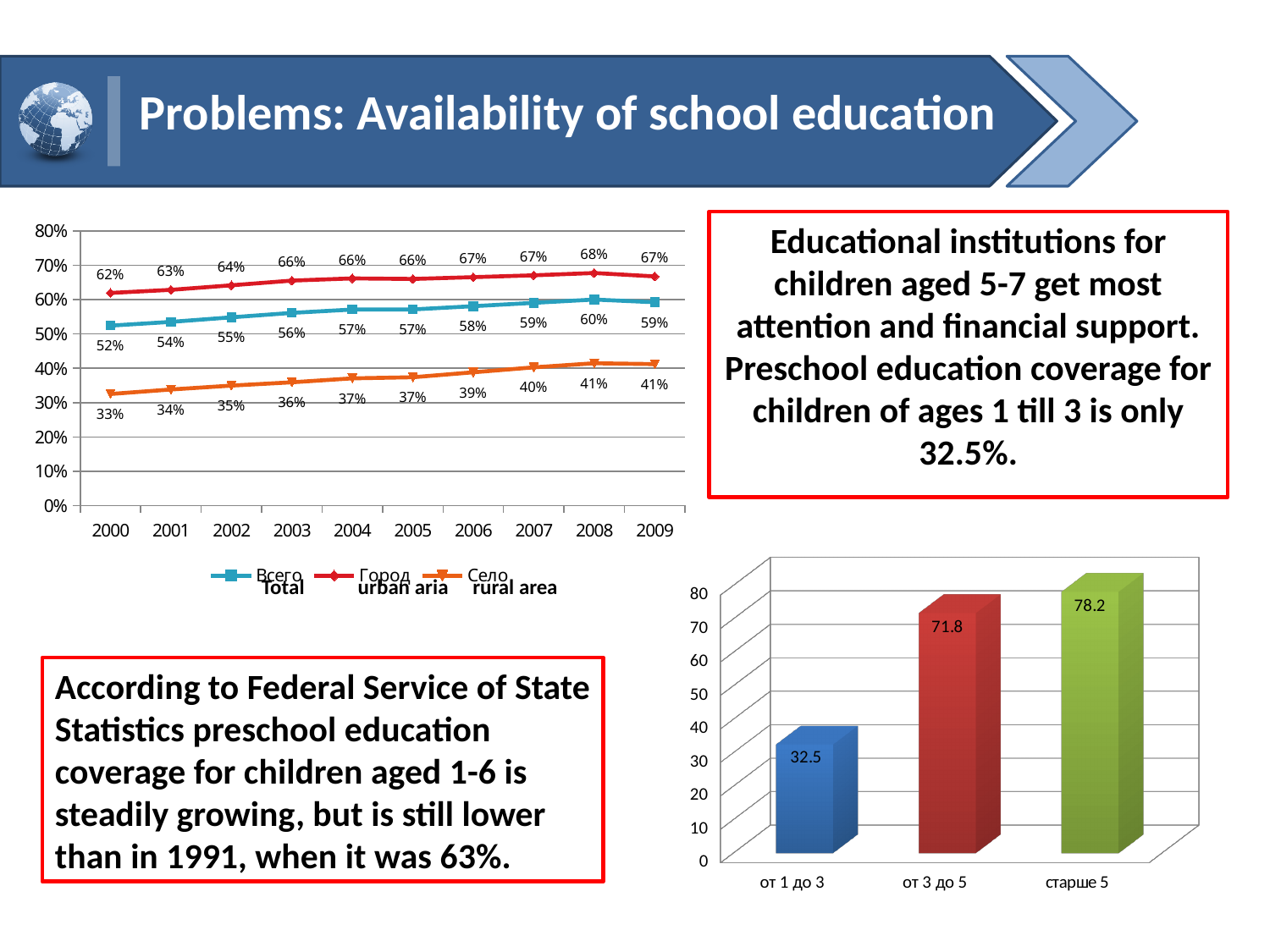
In the line chart on the left, what is the value for the urban series in 2008? 68% What kind of chart is shown on the bottom right of the slide? bar chart In the line chart on the left, does the rural series generally rise or fall from 2000 to 2009? rise In the line chart on the left, how many series does the legend list? 3 In the line chart on the left, which year has the highest value for the Total series? 2008 In the bar chart on the bottom right, what is the value for 'от 3 до 5'? 71.8 In the bar chart on the bottom right, which category has the lowest value? от 1 до 3 In the line chart on the left, how many years are shown on the x axis? 10 In the bar chart on the bottom right, what is the difference between 'старше 5' and 'от 1 до 3'? 45.7 In the line chart on the left, what is the value for the Total series in 2005? 57% In the line chart on the left, what is the difference between the urban and rural values in 2009? 26% In the line chart on the left, what is the value for the rural series in 2000? 33%